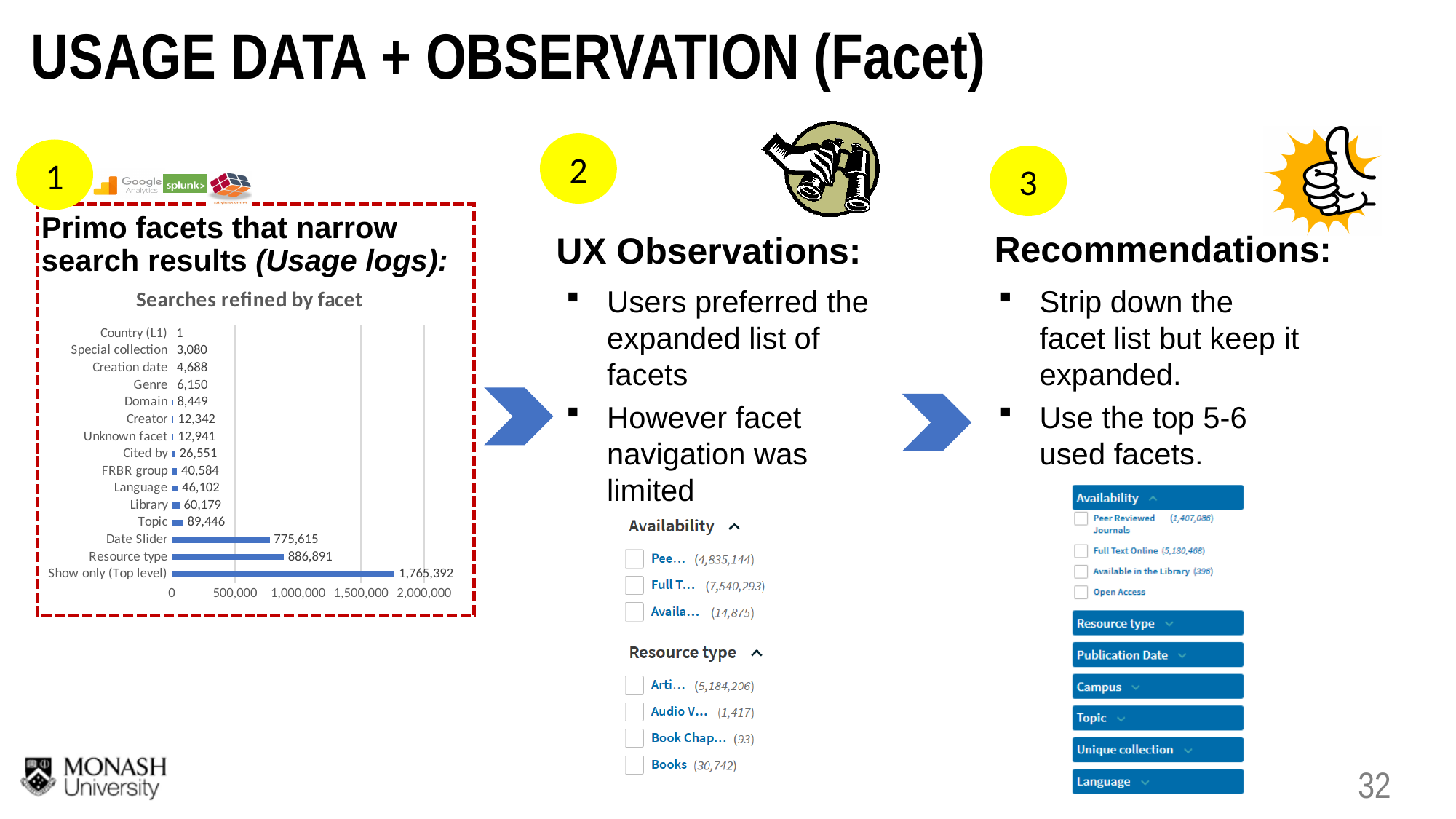
Which facet has the lowest value in the 'Searches refined by facet' chart? Country (L1) In the 'Searches refined by facet' chart, what is the value for Topic? 89,446 In the 'Searches refined by facet' chart, what is the value for Resource type? 886,891 In the 'Searches refined by facet' chart, what is the value for Language? 46,102 Which facet has the highest value in the 'Searches refined by facet' chart? Show only (Top level) In the 'Searches refined by facet' chart, what is the value for Date Slider? 775,615 How many facet categories are shown in the 'Searches refined by facet' chart? 15 What type of chart is 'Searches refined by facet'? bar chart In the 'Searches refined by facet' chart, is the value for Show only (Top level) greater or less than 1,500,000? greater In the 'Searches refined by facet' chart, what is the difference between Show only (Top level) and Resource type? 878,501 In the 'Searches refined by facet' chart, which is larger: Library or Cited by? Library What is the title of the chart on the slide? Searches refined by facet